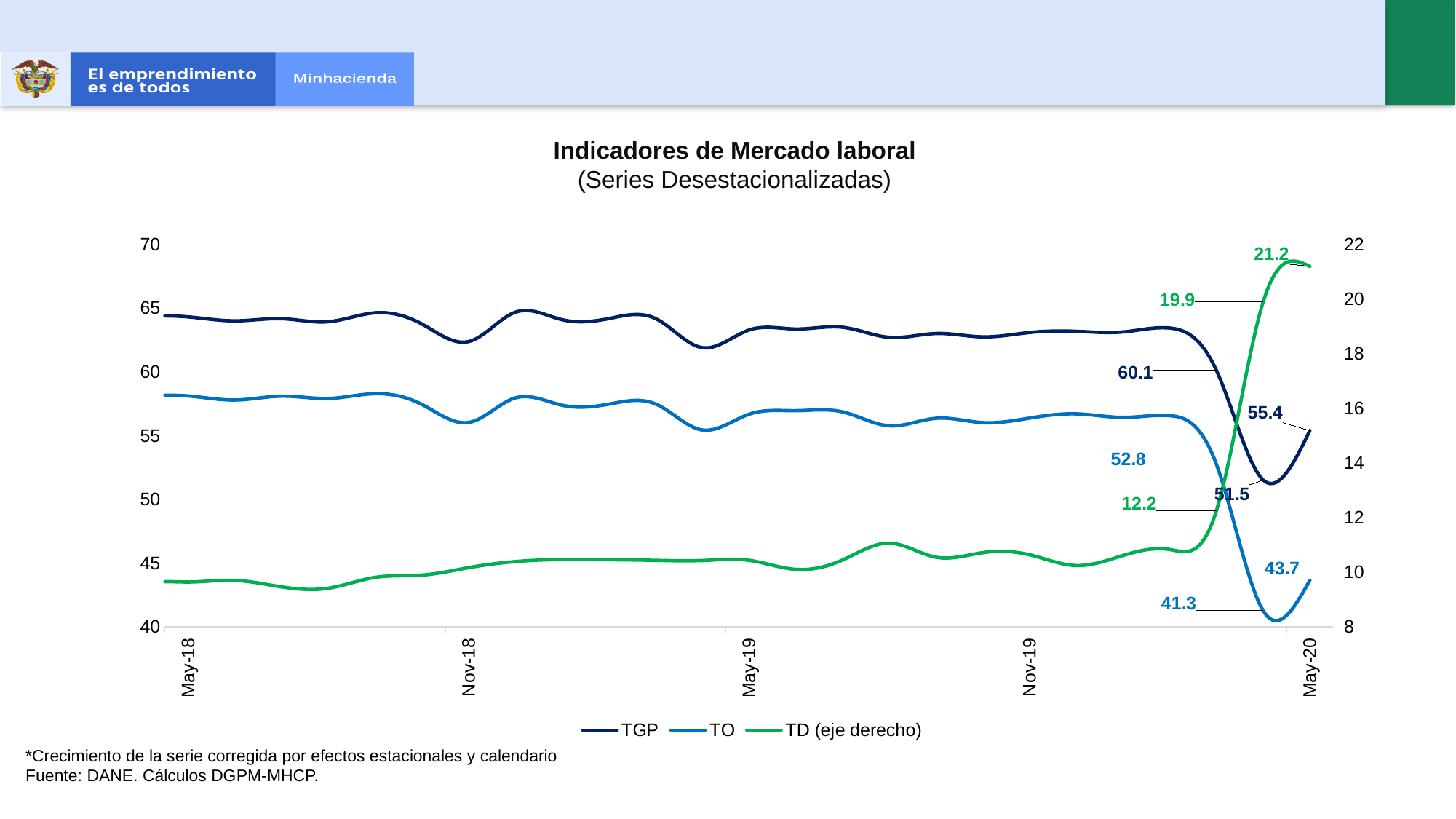
Does the TD (eje derecho) series rise or fall between Nov-19 and May-20? rise What is the value of TD (eje derecho) at May-20? 21.2 What is the value of TGP at May-20? 55.4 What is the lowest labelled value of the TO series? 41.3 What is the highest labelled value of the TD (eje derecho) series? 21.2 Which series is plotted on the right-hand axis? TD (eje derecho) What kind of chart is shown on the slide? line chart What is the difference between the TGP value of 60.1 and the following labelled TGP value of 51.5? 8.6 At May-20, which is larger, TGP or TO? TGP How many series does the legend list? 3 Is the value for TGP at May-18 greater or less than 60? greater What is the value of TO at May-20? 43.7